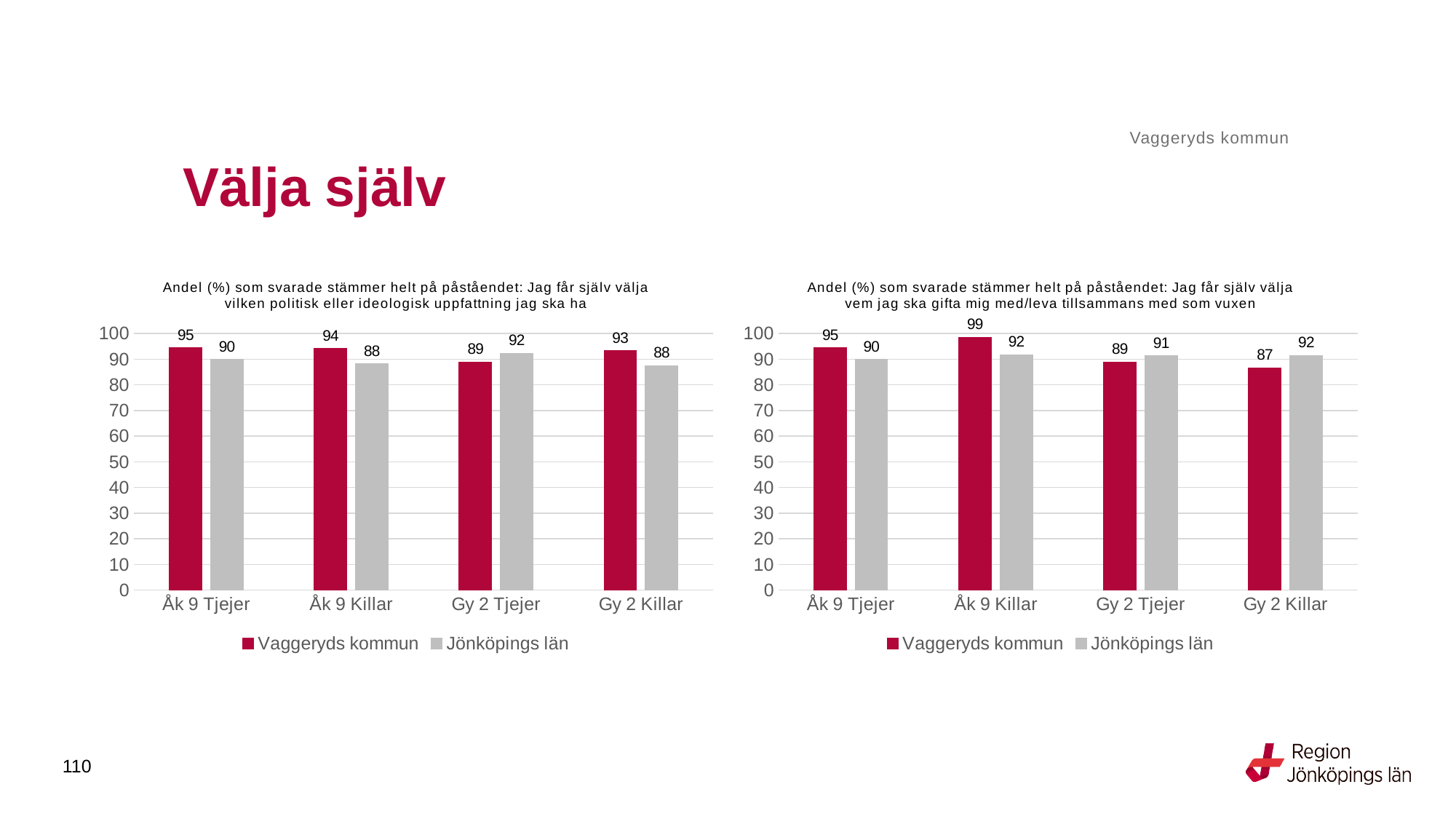
In the left chart (political or ideological opinion), what is the value for Vaggeryds kommun for Åk 9 Tjejer? 95 In the left chart (political or ideological opinion), what is the difference between Vaggeryds kommun and Jönköpings län for Åk 9 Killar? 6 How many series does the legend of the right chart list? 2 In the left chart (political or ideological opinion), which is larger for Gy 2 Tjejer: Vaggeryds kommun or Jönköpings län? Jönköpings län In the right chart (whom to marry/live with), what is the difference between Vaggeryds kommun and Jönköpings län for Åk 9 Killar? 7 In the right chart (whom to marry/live with), what is the value for Jönköpings län for Gy 2 Killar? 92 In the right chart (whom to marry/live with), what is the value for Vaggeryds kommun for Åk 9 Killar? 99 In the right chart (whom to marry/live with), which category has the lowest value for Vaggeryds kommun? Gy 2 Killar How many categories are shown on the x axis of the left chart? 4 In the left chart (political or ideological opinion), what is the value for Jönköpings län for Gy 2 Tjejer? 92 What kind of chart is the left chart? Bar chart In the right chart (whom to marry/live with), which category has the highest value for Vaggeryds kommun? Åk 9 Killar